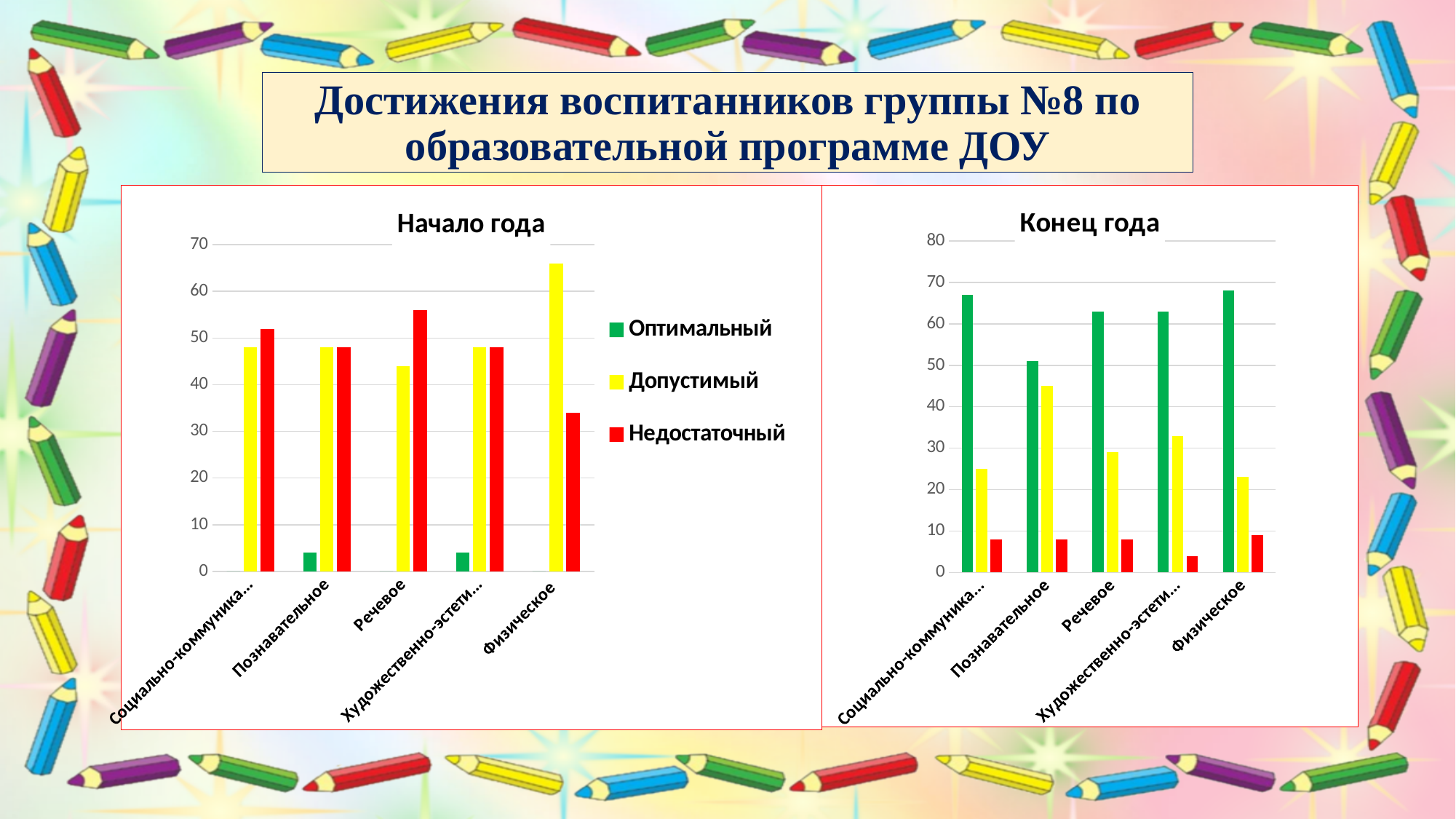
In the "Конец года" chart, which category has the lowest Недостаточный value? Художественно-эстети... How many series does the legend list? 3 In the "Начало года" chart, which category has the highest Допустимый value? Физическое What kind of chart is the "Начало года" chart? bar chart Which colour represents the Недостаточный series in the legend? red In the "Начало года" chart, is the Допустимый value for Физическое greater or less than 60? greater In the "Конец года" chart, which category has the highest Оптимальный value? Физическое In the "Начало года" chart, which is larger for Речевое: the Допустимый value or the Недостаточный value? Недостаточный In the "Конец года" chart, which is larger for Познавательное: the Оптимальный value or the Допустимый value? Оптимальный In the "Начало года" chart, is the Недостаточный value for Физическое greater or less than 40? less How many categories are shown on the x axis of the "Конец года" chart? 5